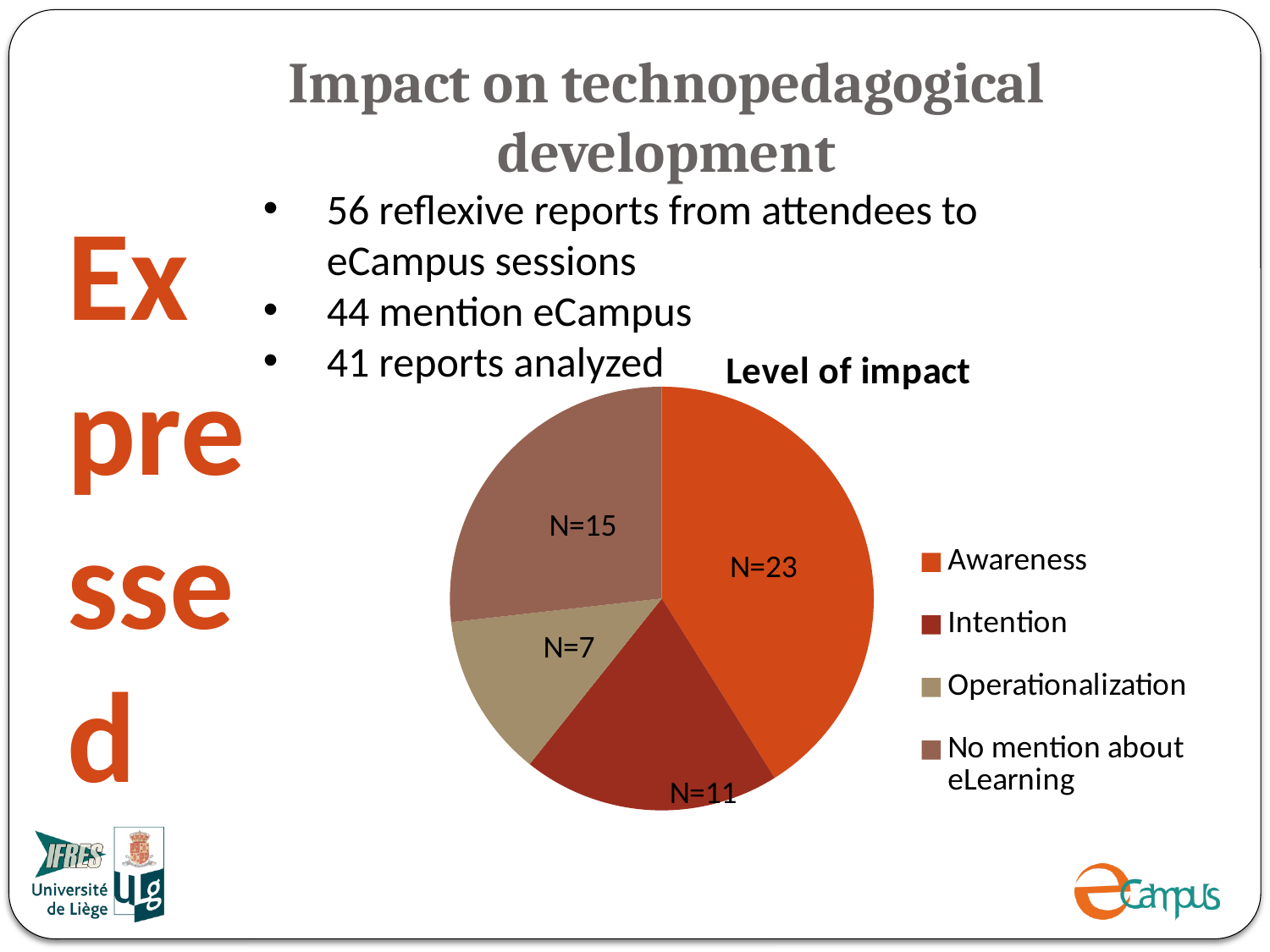
What is the value shown for the "No mention about eLearning" slice in the "Level of impact" pie chart? N=15 Which category has the largest slice in the "Level of impact" pie chart? Awareness What is the value shown for the Operationalization slice in the "Level of impact" pie chart? N=7 In the "Level of impact" pie chart, which is larger: Intention or No mention about eLearning? No mention about eLearning What is the title of the pie chart on the slide? Level of impact What is the total of all the slice values in the "Level of impact" pie chart? 56 What is the value shown for the Intention slice in the "Level of impact" pie chart? N=11 In the "Level of impact" pie chart, how much larger is the Awareness value than the Intention value? 12 How many slices does the "Level of impact" pie chart have? 4 What is the value shown for the Awareness slice in the "Level of impact" pie chart? N=23 Which category has the smallest slice in the "Level of impact" pie chart? Operationalization What kind of chart is shown under the title "Level of impact"? pie chart